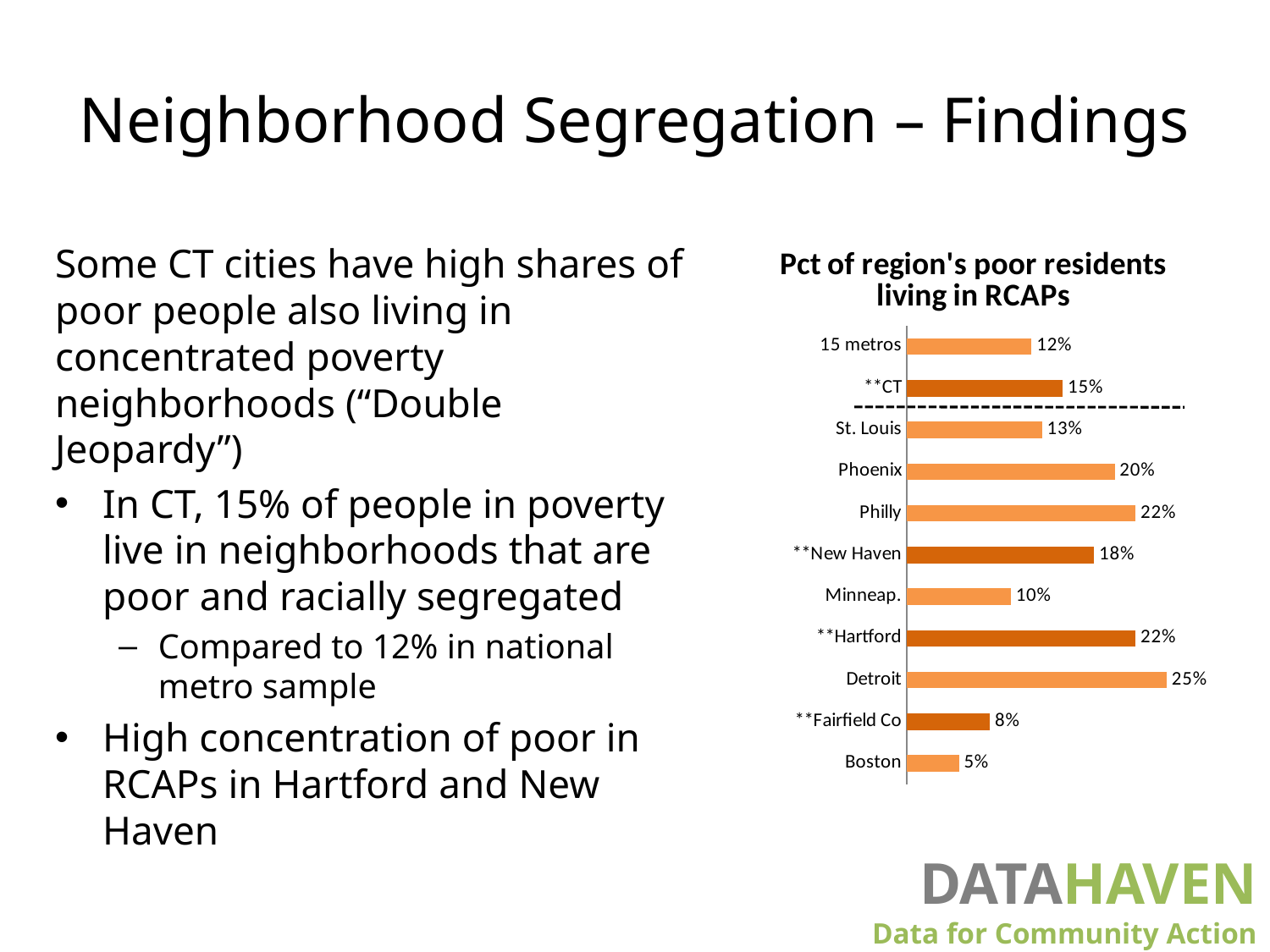
What kind of chart is shown on the slide? Bar chart What is the difference between the values for **CT and 15 metros? 3% What is the value for 15 metros in the chart? 12% How many categories are shown in the chart? 11 What is the value for Detroit in the chart? 25% What is the value for **Fairfield Co in the chart? 8% Which has a larger value, Minneap. or **New Haven? **New Haven Which has a larger value, Phoenix or St. Louis? Phoenix What is the value for **New Haven in the chart? 18% Which category has the highest value in the chart? Detroit What is the difference between the values for Detroit and Boston? 20% Which category has the lowest value in the chart? Boston